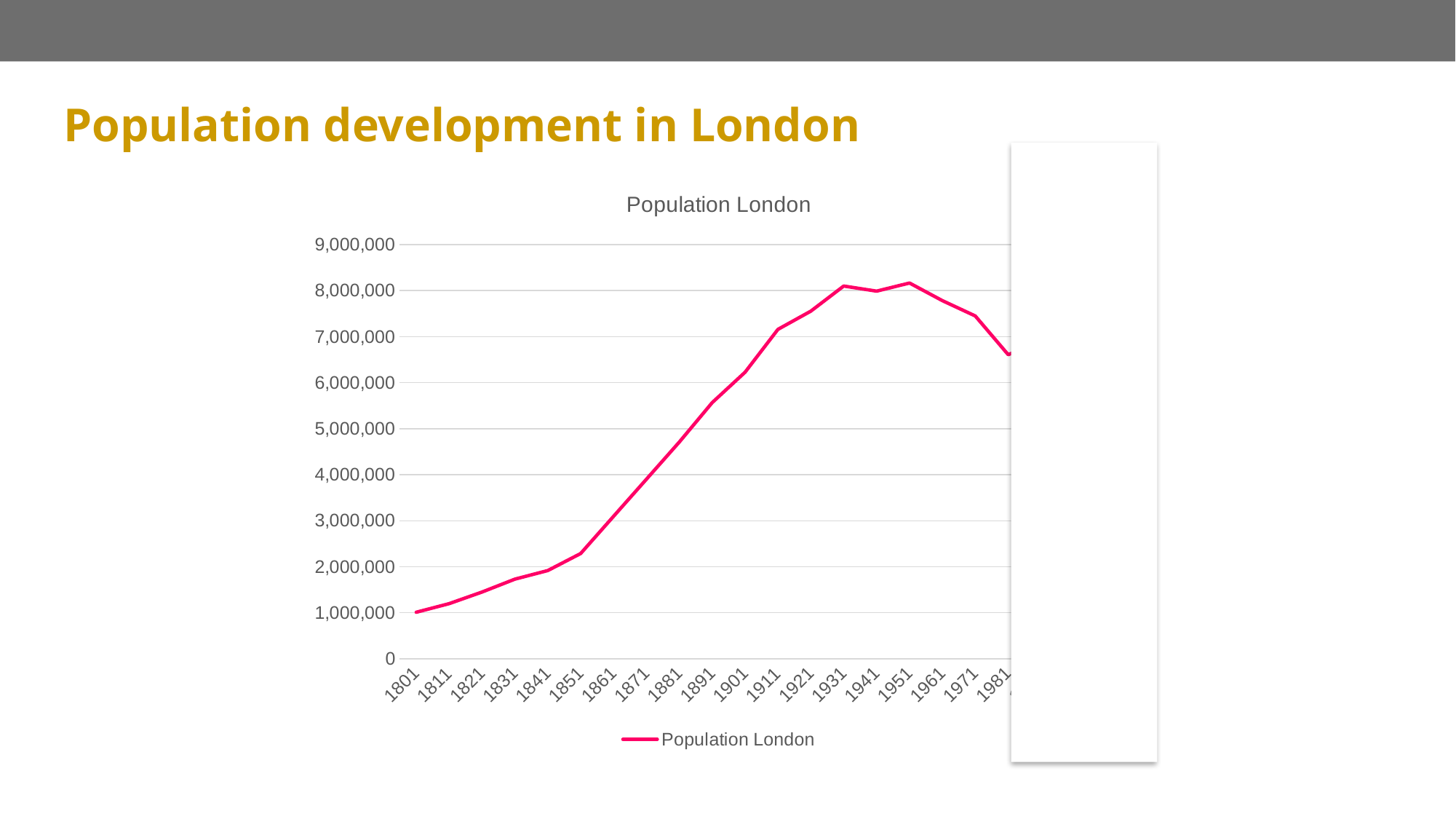
Is the value for 1851 greater or less than 2,000,000? greater Which is larger, the value for 1901 or the value for 1851? 1901 Which year has the lowest population value on the chart? 1801 Is the value for 1871 greater or less than 3,000,000? greater How many series does the legend list? 1 What is the title of the chart? Population London Is the value for 1981 greater or less than 7,000,000? less What kind of chart is shown on the slide? Line chart Which is larger, the value for 1951 or the value for 1981? 1951 Does the population rise or fall between 1801 and 1901? Rise